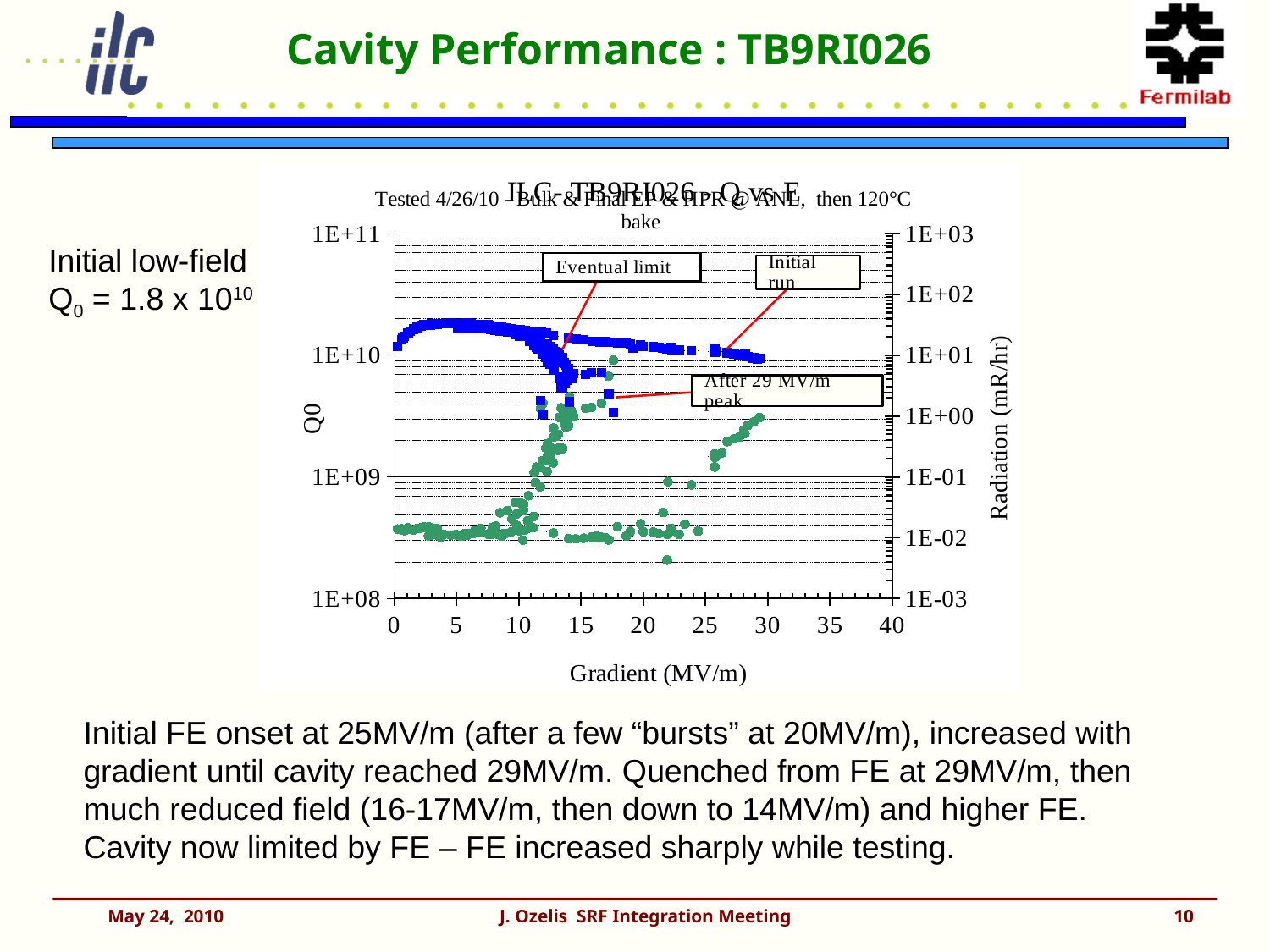
Is the Q0 value at a gradient of 5 MV/m greater or less than 1E+10? greater How many text annotations (callout boxes) are placed on the chart? 3 What is the label of the x axis of the chart? Gradient (MV/m) What is the lowest tick value shown on the right-hand Radiation axis? 1E-03 What is the highest tick value shown on the left-hand Q0 axis? 1E+11 Is the radiation value at a gradient of 5 MV/m greater or less than 1E-01 mR/hr? less Does the radiation (green circle) series rise or fall as the gradient increases from 10 MV/m to 29 MV/m? Rise Is the radiation value at a gradient of about 29 MV/m greater or less than 1E-01 mR/hr? greater What kind of chart is shown on the slide? Scatter chart What is the highest tick value shown on the x axis of the chart? 40 Does the Q0 (blue square) series rise or fall as the gradient increases from 5 MV/m to 29 MV/m? Fall What is the label of the right-hand y axis of the chart? Radiation (mR/hr)